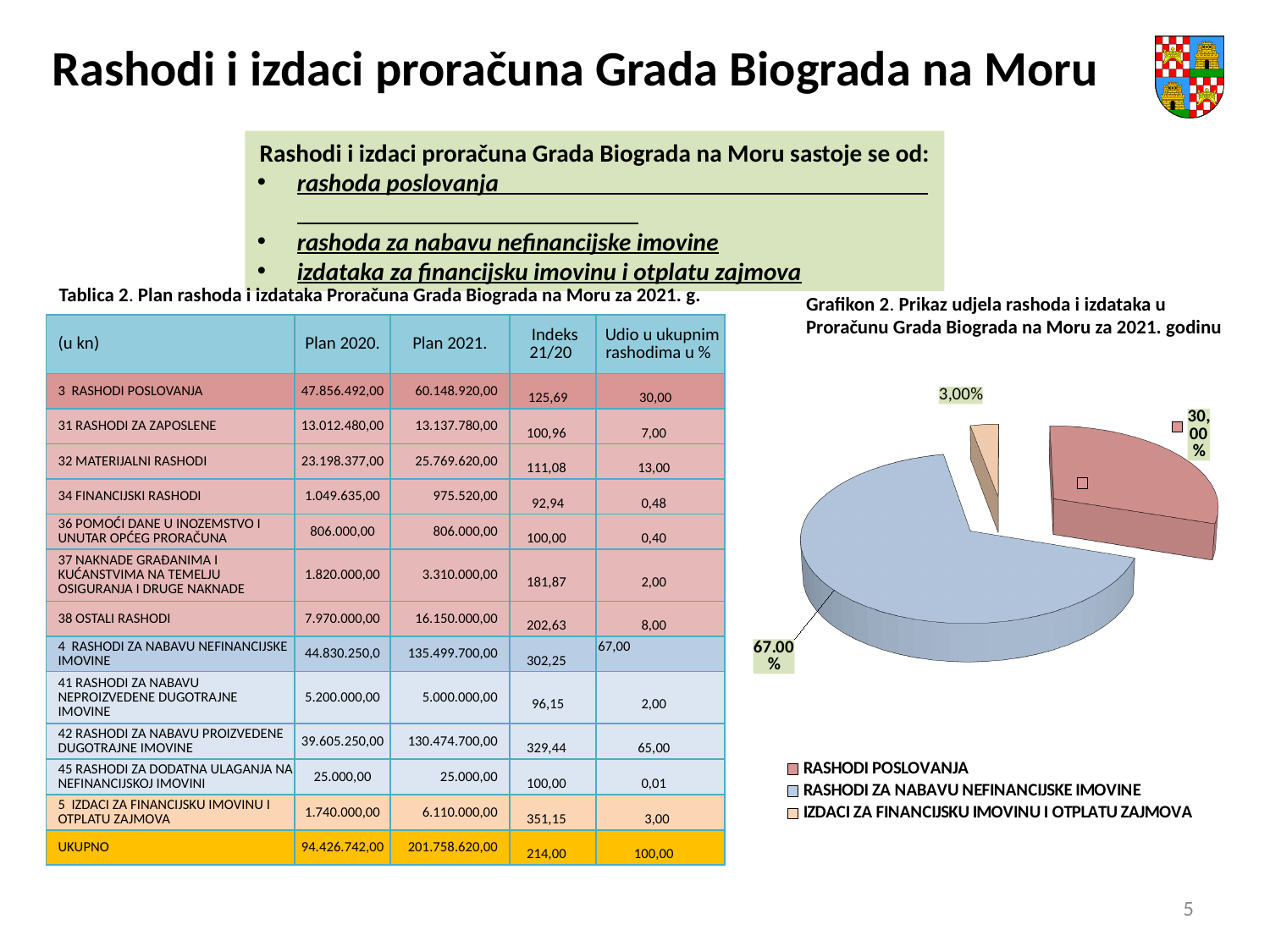
What share of the pie does RASHODI POSLOVANJA have? 30,00% Which category has the largest slice in the pie chart? RASHODI ZA NABAVU NEFINANCIJSKE IMOVINE How many entries does the legend of the pie chart list? 3 Which category has the smallest slice in the pie chart? IZDACI ZA FINANCIJSKU IMOVINU I OTPLATU ZAJMOVA Which is larger in the pie chart: RASHODI POSLOVANJA or IZDACI ZA FINANCIJSKU IMOVINU I OTPLATU ZAJMOVA? RASHODI POSLOVANJA Which legend entry is shown in red/pink in the pie chart? RASHODI POSLOVANJA What share of the pie does IZDACI ZA FINANCIJSKU IMOVINU I OTPLATU ZAJMOVA have? 3,00% What kind of chart is shown on the slide? pie chart How many slices does the pie chart have? 3 What share of the pie does RASHODI ZA NABAVU NEFINANCIJSKE IMOVINE have? 67.00% What is the title of the pie chart? Grafikon 2. Prikaz udjela rashoda i izdataka u Proračunu Grada Biograda na Moru za 2021. godinu What is the difference in percentage points between the RASHODI ZA NABAVU NEFINANCIJSKE IMOVINE slice and the RASHODI POSLOVANJA slice? 37,00